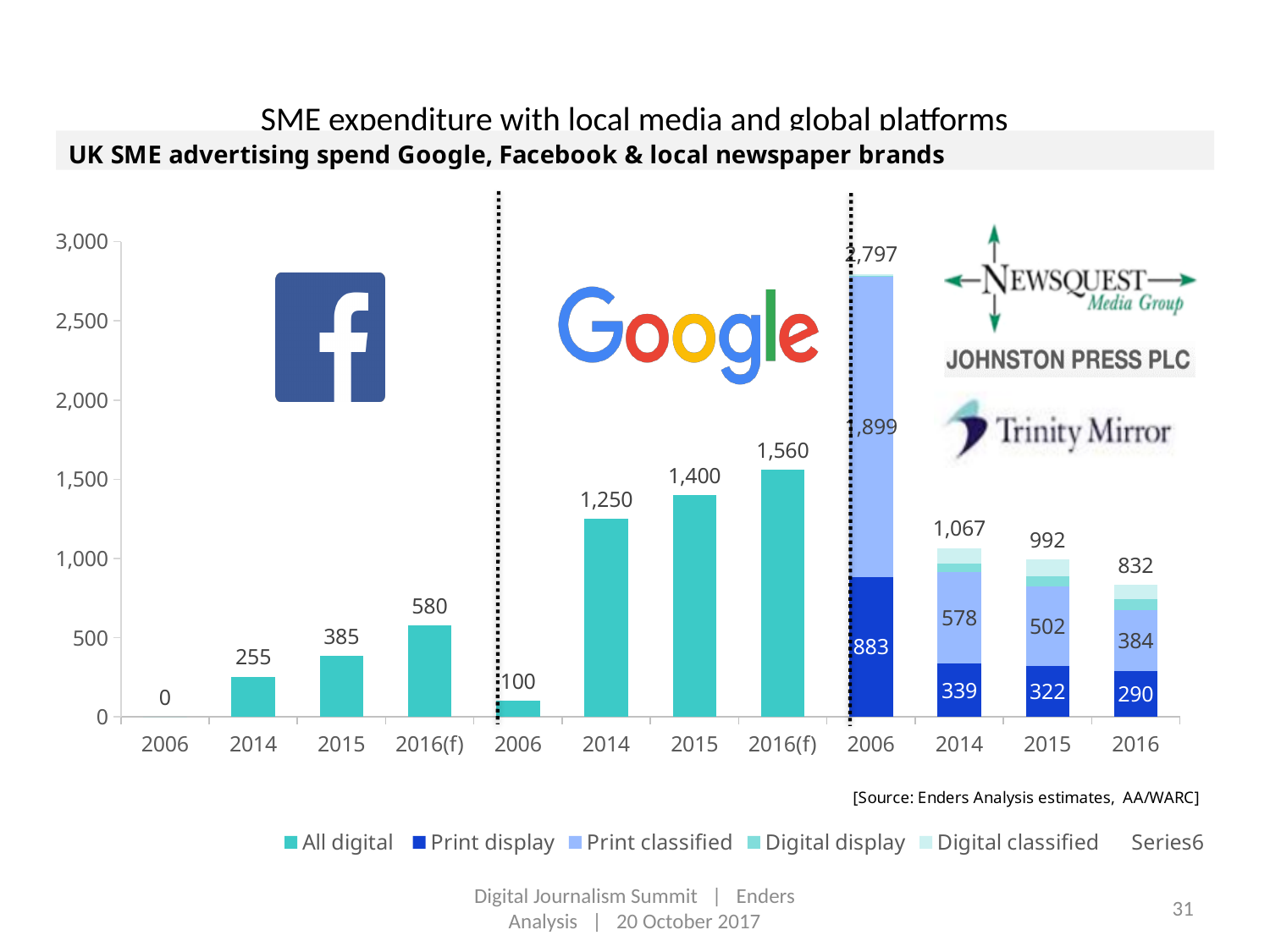
Which year has the lowest total for local newspaper brands? 2016 Which is larger: Facebook's All digital value in 2016(f) or Google's All digital value in 2006? Facebook 2016(f) What is the Print display value for local newspaper brands in 2006? 883 How many entries does the legend list? 6 What kind of chart is shown on the slide? bar chart What is the difference between Google's All digital value in 2015 and 2014? 150 What is the All digital value for Facebook in 2015? 385 What is the Print classified value for local newspaper brands in 2015? 502 Do Facebook's All digital values rise or fall from 2006 to 2016(f)? rise What is the total of the stacked bar for local newspaper brands in 2014? 1,067 What is the All digital value for Google in 2016(f)? 1,560 Which year has the highest All digital value for Google? 2016(f)